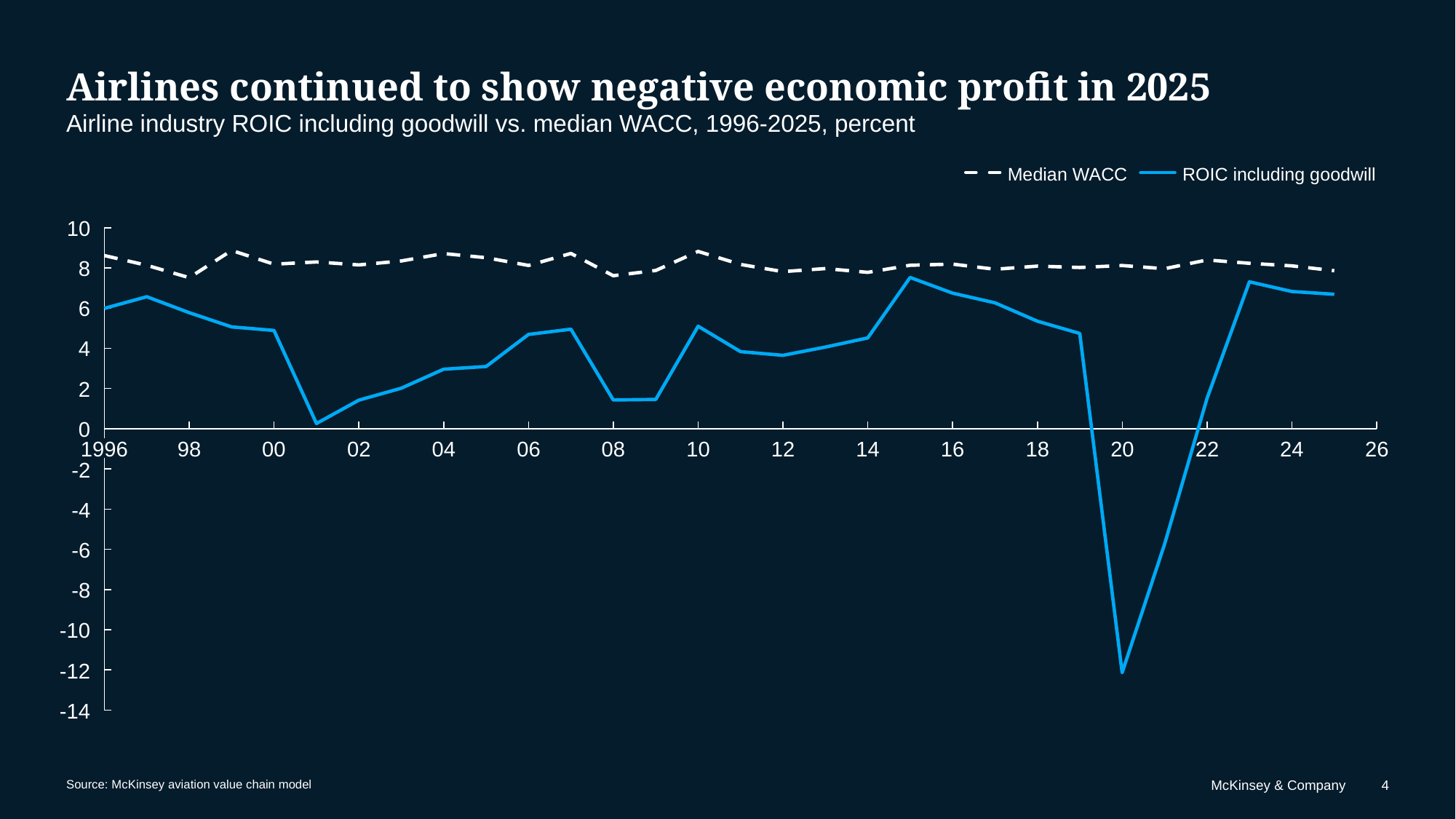
Is the value of ROIC including goodwill in 2001 greater or less than 2? less Does ROIC including goodwill rise or fall between 2020 and 2023? Rise What is the title of the slide? Airlines continued to show negative economic profit in 2025 In which year is ROIC including goodwill at its lowest? 2020 In 2025, which is higher: Median WACC or ROIC including goodwill? Median WACC How many series does the legend list? 2 In 2008, which is higher: Median WACC or ROIC including goodwill? Median WACC What type of chart is shown on the slide? Line chart Is the value of ROIC including goodwill in 2020 greater or less than -10? less What are the two series named in the legend? Median WACC and ROIC including goodwill Is the value of Median WACC in 1996 greater or less than 8? greater